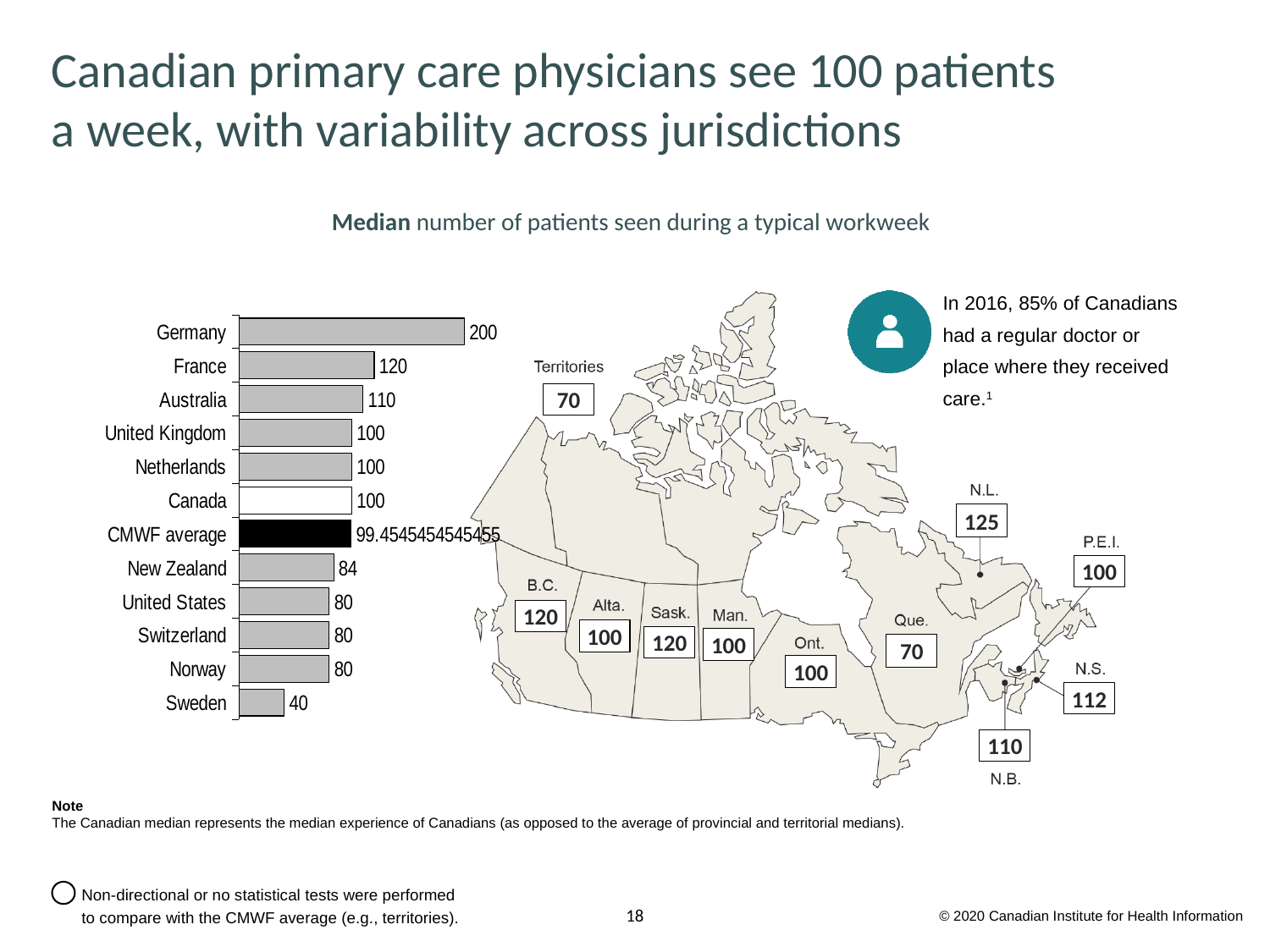
In the bar chart, which country has the lowest median number of patients seen per week? Sweden On the map of Canada, what is the median number of patients seen per week in N.L.? 125 In the bar chart, what is the value shown for Canada? 100 In the bar chart, what is the difference between the values for Germany and France? 80 In the bar chart, what is the difference between the values for Canada and Sweden? 60 What type of chart is used to show the median number of patients by country? Bar chart In the bar chart, what is the value shown for the CMWF average? 99.4545454545455 In the bar chart, which country has the highest median number of patients seen per week? Germany In the bar chart, what is the median number of patients seen per week in Germany? 200 In the bar chart, which has a higher value, Australia or New Zealand? Australia How many categories (bars) are shown in the bar chart? 12 In the bar chart, which bar is coloured black? CMWF average